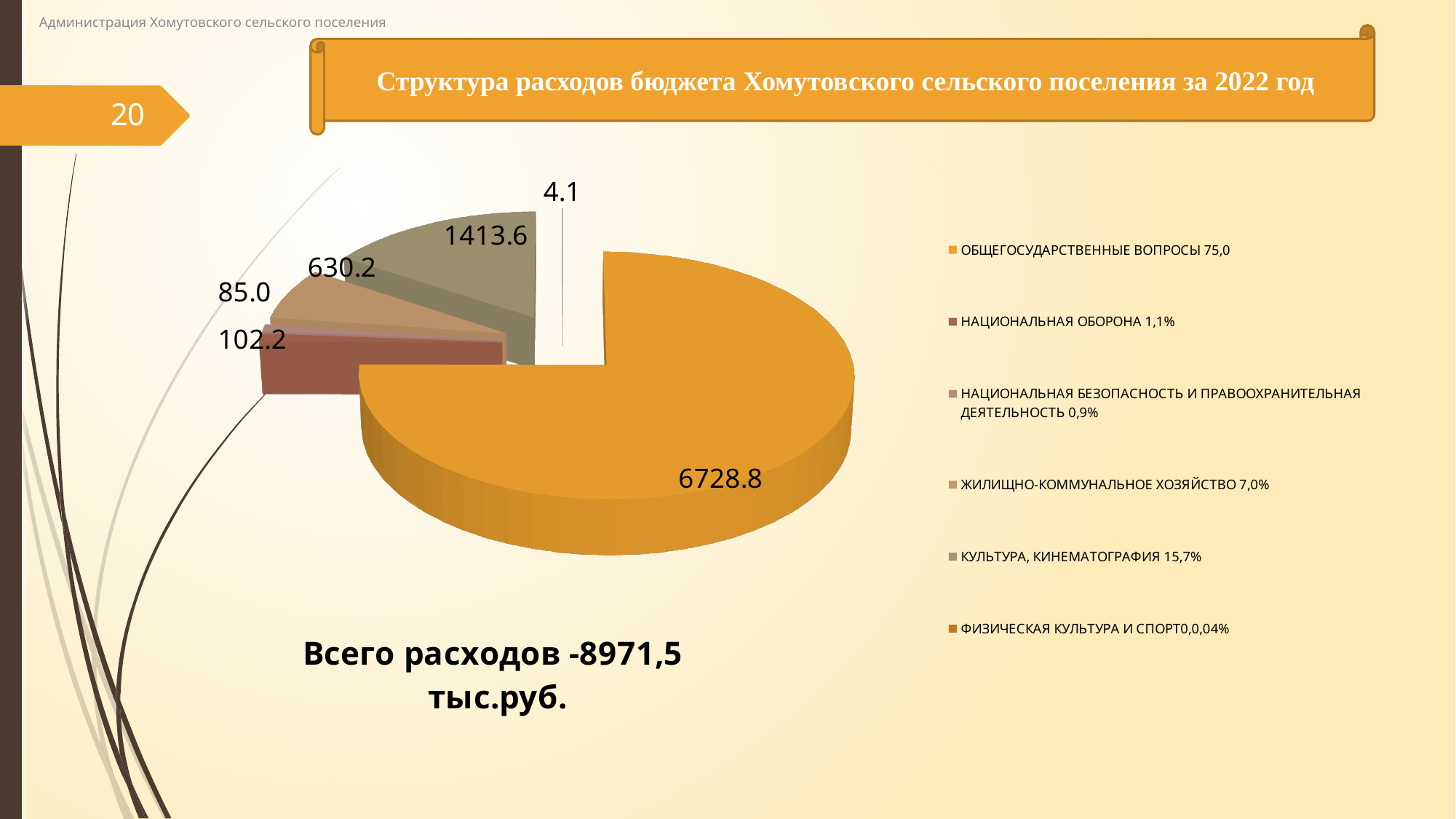
According to the legend, what share of the pie does КУЛЬТУРА, КИНЕМАТОГРАФИЯ represent? 15,7% What value is shown for the ЖИЛИЩНО-КОММУНАЛЬНОЕ ХОЗЯЙСТВО slice? 630.2 How many slices does the pie chart have? 6 Which category has the largest slice of the pie? ОБЩЕГОСУДАРСТВЕННЫЕ ВОПРОСЫ What value is shown for the ОБЩЕГОСУДАРСТВЕННЫЕ ВОПРОСЫ slice? 6728.8 What is the difference between the ОБЩЕГОСУДАРСТВЕННЫЕ ВОПРОСЫ value and the КУЛЬТУРА, КИНЕМАТОГРАФИЯ value? 5315.2 What value is shown for the КУЛЬТУРА, КИНЕМАТОГРАФИЯ slice? 1413.6 Which is larger: the value for КУЛЬТУРА, КИНЕМАТОГРАФИЯ or the value for ЖИЛИЩНО-КОММУНАЛЬНОЕ ХОЗЯЙСТВО? КУЛЬТУРА, КИНЕМАТОГРАФИЯ What value is shown for the НАЦИОНАЛЬНАЯ ОБОРОНА slice? 102.2 What kind of chart is shown on the slide? Pie chart What is the title of the chart on the slide? Всего расходов -8971,5 тыс.руб. Which category has the smallest slice of the pie? ФИЗИЧЕСКАЯ КУЛЬТУРА И СПОРТ